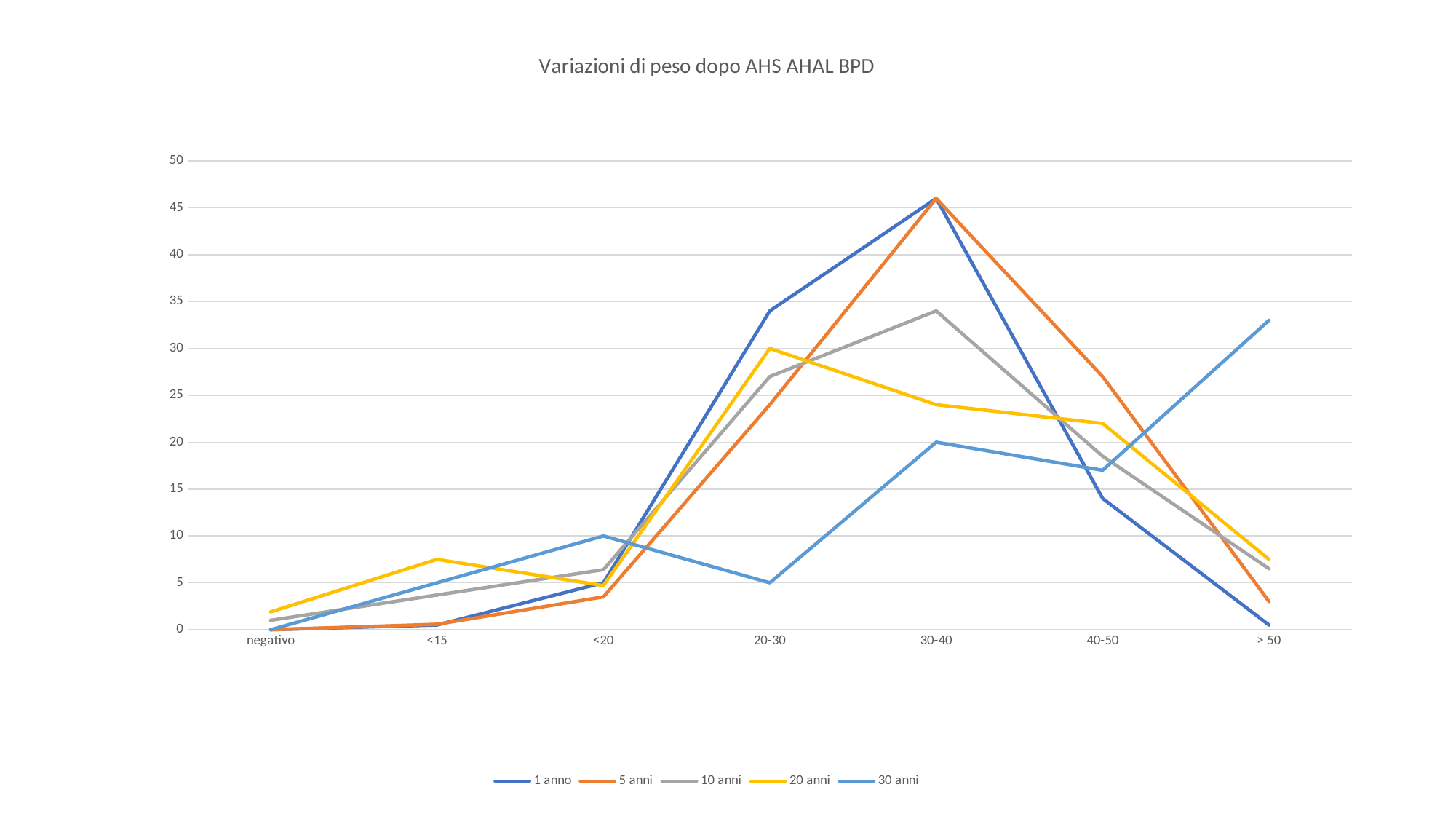
What is the title of the chart? Variazioni di peso dopo AHS AHAL BPD Does the '1 anno' series rise or fall from '30-40' to '> 50'? fall Is the value for '5 anni' at '30-40' greater or less than 40? greater What kind of chart is shown on the slide? line chart What is the value for '20 anni' at '20-30'? 30 At '40-50', which series has the larger value: '5 anni' or '1 anno'? 5 anni Which category has the highest value for the '30 anni' series? > 50 How many series does the legend list? 5 What is the value for '30 anni' at '<20'? 10 How many categories are shown on the x axis? 7 Which category has the highest value for the '1 anno' series? 30-40 Is the value for '10 anni' at '> 50' greater or less than 10? less